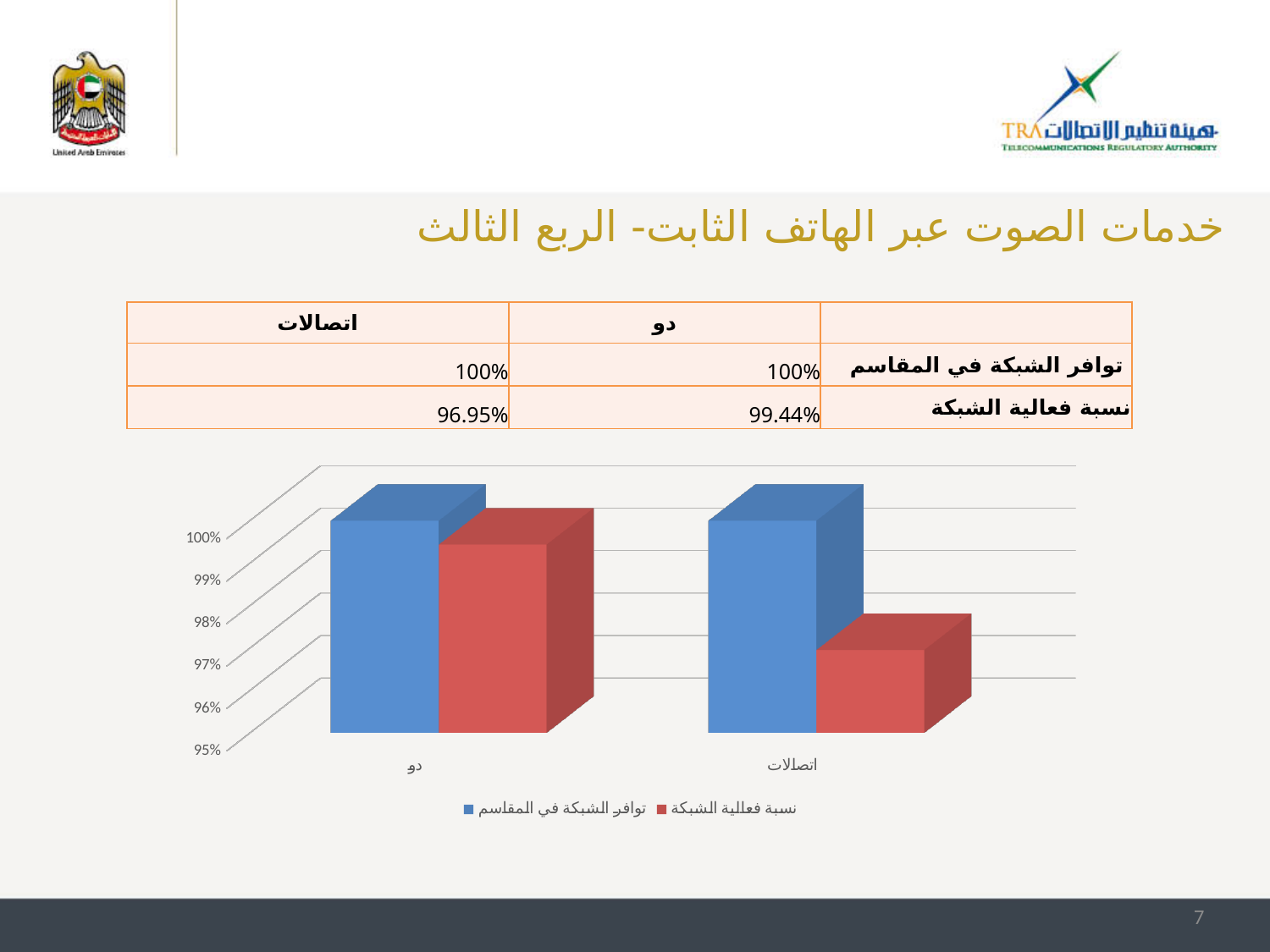
What is the value of توافر الشبكة في المقاسم for دو? 100% What is the value of نسبة فعالية الشبكة for دو? 99.44% How many categories are shown on the x axis of the chart? 2 What is the title of the slide containing the chart? خدمات الصوت عبر الهاتف الثابت- الربع الثالث What is the difference between the نسبة فعالية الشبكة values for دو and اتصالات? 2.49% What is the value of توافر الشبكة في المقاسم for اتصالات? 100% Is the نسبة فعالية الشبكة value for دو greater or less than 99%? greater Which operator has the higher نسبة فعالية الشبكة, دو or اتصالات? دو What is the value of نسبة فعالية الشبكة for اتصالات? 96.95% Is the نسبة فعالية الشبكة value for اتصالات greater or less than 98%? less How many series does the chart legend list? 2 What kind of chart is shown on the slide? bar chart